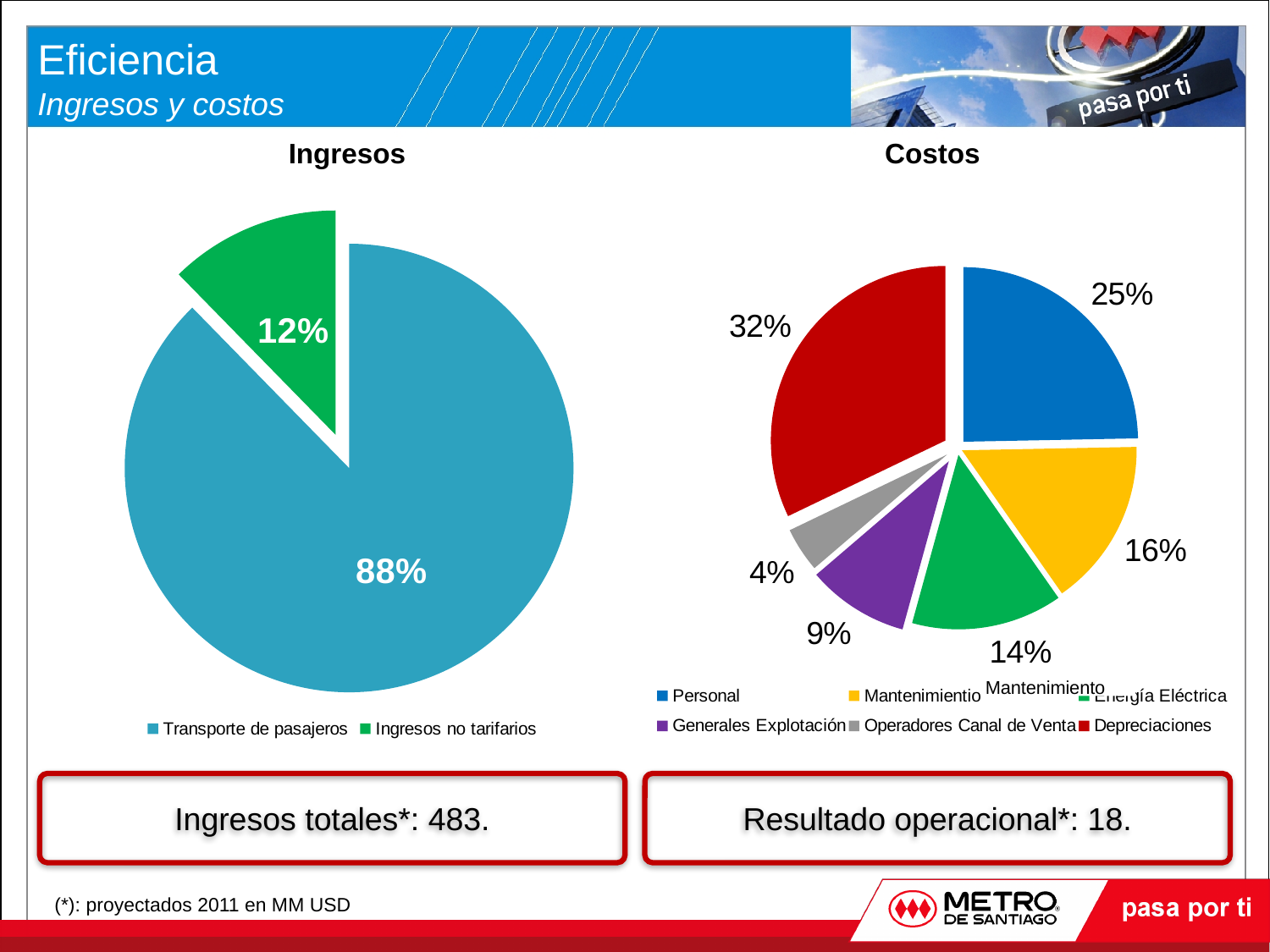
In the Ingresos chart, what share does Transporte de pasajeros have? 88% In the Costos chart, which is larger, Generales Explotación or Energía Eléctrica? Energía Eléctrica How many categories does the legend of the Costos chart list? 6 In the Costos chart, what share does Personal have? 25% In the Costos chart, what colour is the Depreciaciones slice? Red What kind of chart is the Costos chart? Pie chart In the Ingresos chart, what is the difference between the Transporte de pasajeros share and the Ingresos no tarifarios share? 76% In the Costos chart, which category has the largest slice? Depreciaciones In the Ingresos chart, what share does Ingresos no tarifarios have? 12% In the Ingresos chart, which category has the largest slice? Transporte de pasajeros In the Costos chart, which category has the smallest slice? Operadores Canal de Venta